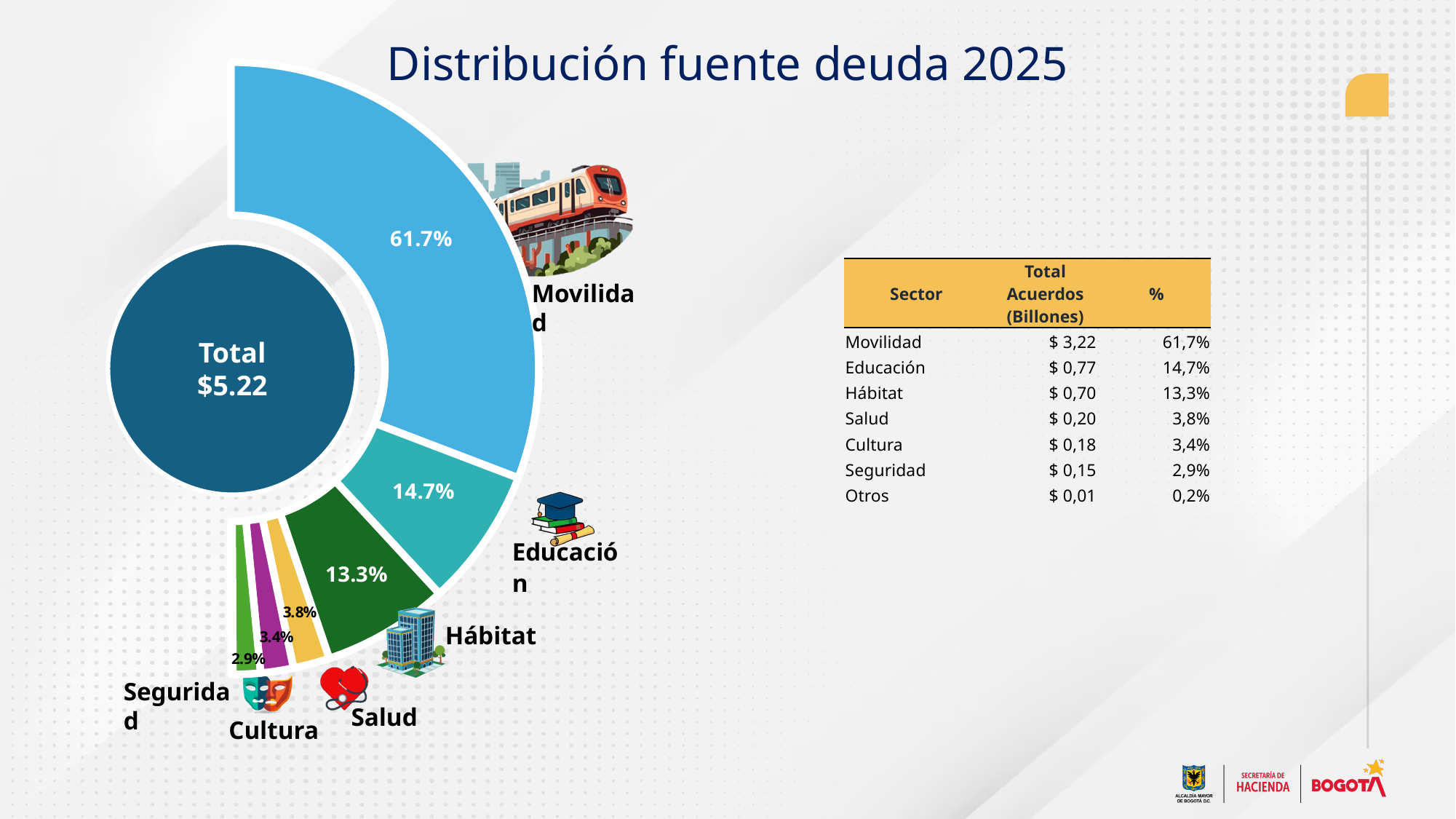
What kind of chart is shown on the slide? doughnut chart What percentage is shown for Hábitat in the pie chart? 13.3% What is the difference in percentage points between the Salud and Cultura slices? 0.4% How many slices in the pie chart have a percentage label printed on them? 6 Which sector has the largest slice in the pie chart? Movilidad What percentage of the pie chart does Movilidad represent? 61.7% What is the difference in percentage points between the Movilidad and Educación slices? 47.0% Among the slices with a printed percentage, which sector has the smallest share? Seguridad What total value is shown in the centre of the pie chart? $5.22 What percentage is shown for Seguridad in the pie chart? 2.9% What percentage is shown for Educación in the pie chart? 14.7% Which slice is larger in the pie chart, Educación or Hábitat? Educación